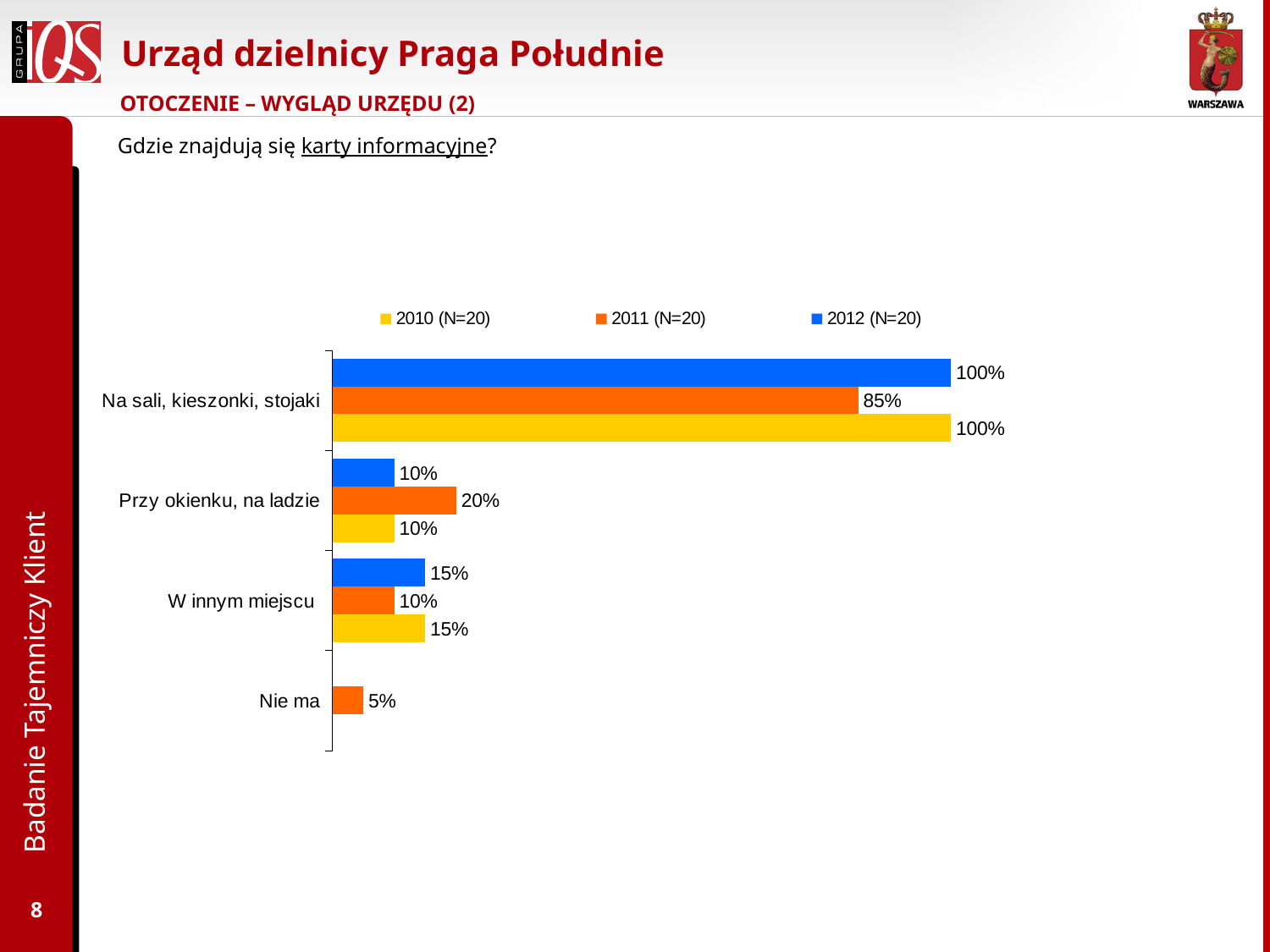
Which colour represents the 2010 (N=20) series? Yellow What is the value for 'W innym miejscu' in the 2012 (N=20) series? 15% Which is larger for 'Przy okienku, na ladzie': the 2011 value or the 2012 value? 2011 What kind of chart is shown on the slide? Bar chart How many series does the legend list? 3 What is the value for 'Nie ma' in the 2011 (N=20) series? 5% How many categories are shown on the chart? 4 Which category has the lowest value in the 2011 (N=20) series? Nie ma What is the value for 'Przy okienku, na ladzie' in the 2011 (N=20) series? 20% What is the value for 'Na sali, kieszonki, stojaki' in the 2011 (N=20) series? 85% Which category has the highest value in the 2012 (N=20) series? Na sali, kieszonki, stojaki What is the difference between the 2012 and 2011 values for 'Na sali, kieszonki, stojaki'? 15%